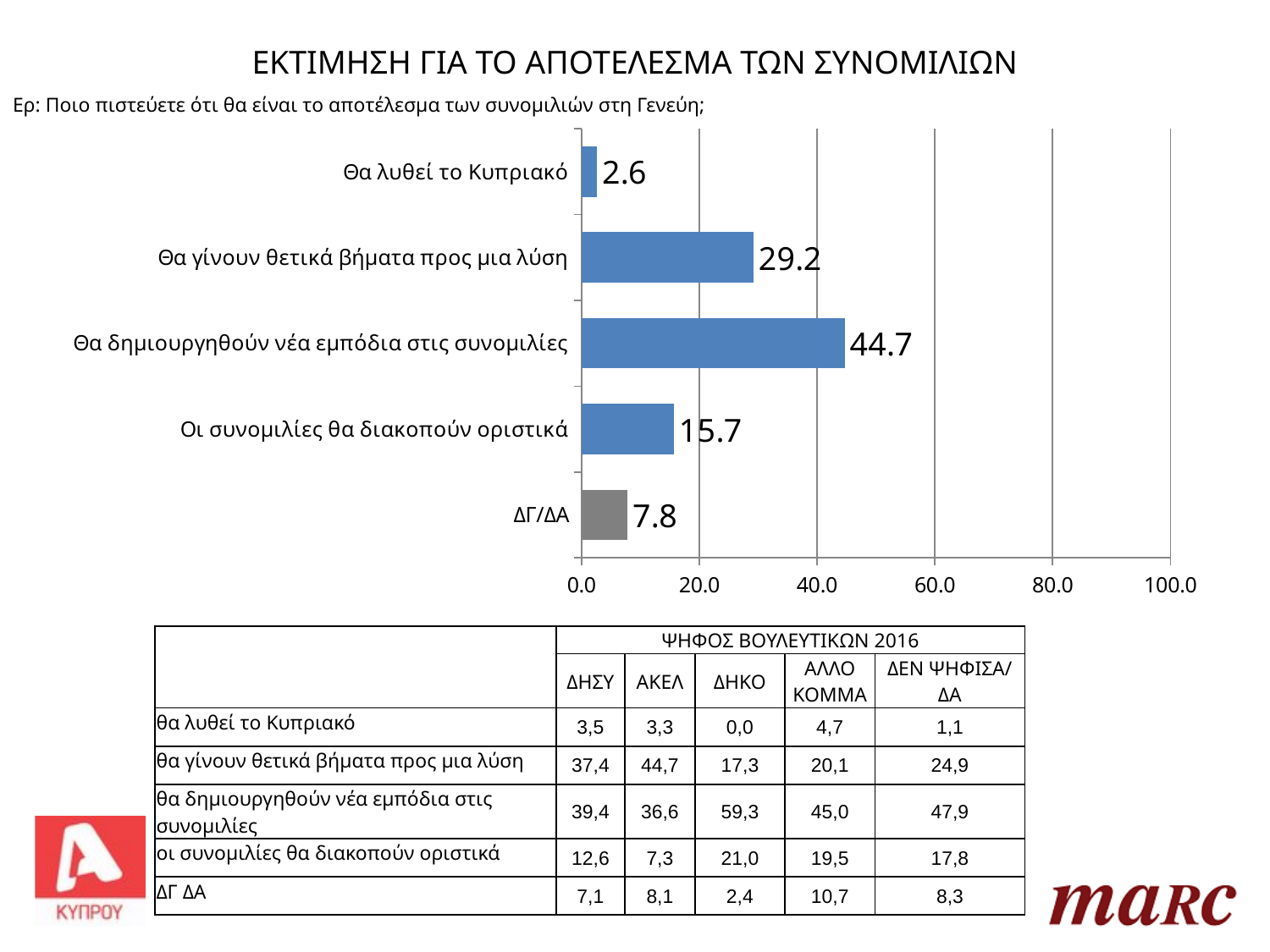
What value is shown for "Οι συνομιλίες θα διακοπούν οριστικά"? 15.7 How many categories are shown in the bar chart? 5 What is the title of the chart? ΕΚΤΙΜΗΣΗ ΓΙΑ ΤΟ ΑΠΟΤΕΛΕΣΜΑ ΤΩΝ ΣΥΝΟΜΙΛΙΩΝ Which is larger: the value for "Οι συνομιλίες θα διακοπούν οριστικά" or the value for "ΔΓ/ΔΑ"? Οι συνομιλίες θα διακοπούν οριστικά Which category has the highest value in the chart? Θα δημιουργηθούν νέα εμπόδια στις συνομιλίες Is the value for "Θα γίνουν θετικά βήματα προς μια λύση" greater or less than 20.0? greater What is the difference between the values for "Θα δημιουργηθούν νέα εμπόδια στις συνομιλίες" and "Θα γίνουν θετικά βήματα προς μια λύση"? 15.5 What value is shown for "Θα δημιουργηθούν νέα εμπόδια στις συνομιλίες"? 44.7 Which category has the lowest value in the chart? Θα λυθεί το Κυπριακό What value is shown for "ΔΓ/ΔΑ"? 7.8 What value is shown for "Θα γίνουν θετικά βήματα προς μια λύση"? 29.2 What type of chart is shown on the slide? bar chart